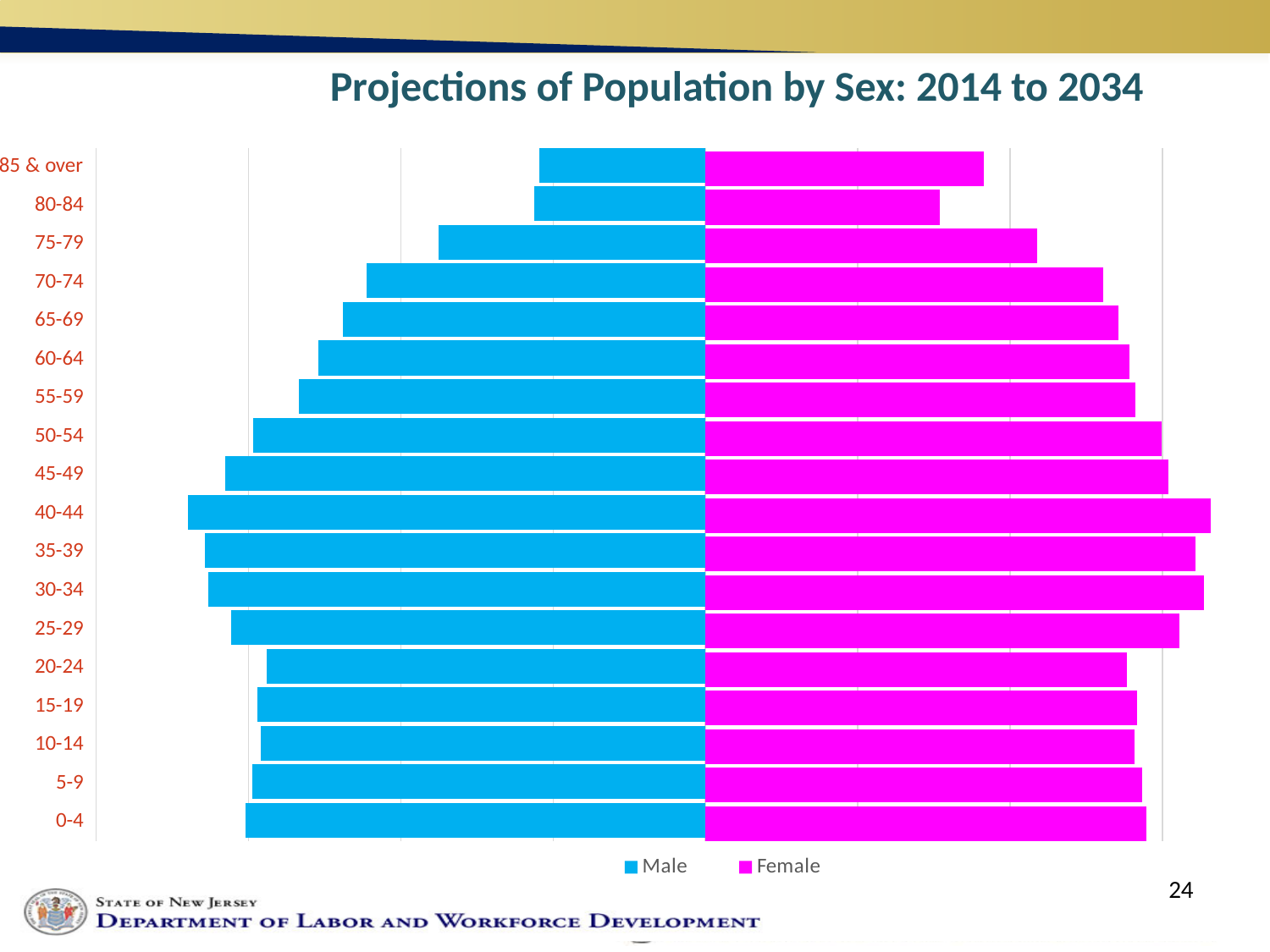
Which is larger, the Female bar for 20-24 or the Female bar for 25-29? 25-29 What are the two series named in the legend? Male and Female How many series does the chart's legend list? 2 Which is larger, the Male bar for 65-69 or the Male bar for 75-79? 65-69 Which age group has the shortest Female bar? 80-84 What is the title of the chart? Projections of Population by Sex: 2014 to 2034 Which is larger, the Male bar for 0-4 or the Male bar for 85 & over? 0-4 Moving from the 40-44 age group up to the 85 & over age group, do the Male bars generally get longer or shorter? Shorter What kind of chart is shown on the slide? Bar chart How many age groups are listed on the vertical axis of the chart? 18 Which age group has the longest Male bar? 40-44